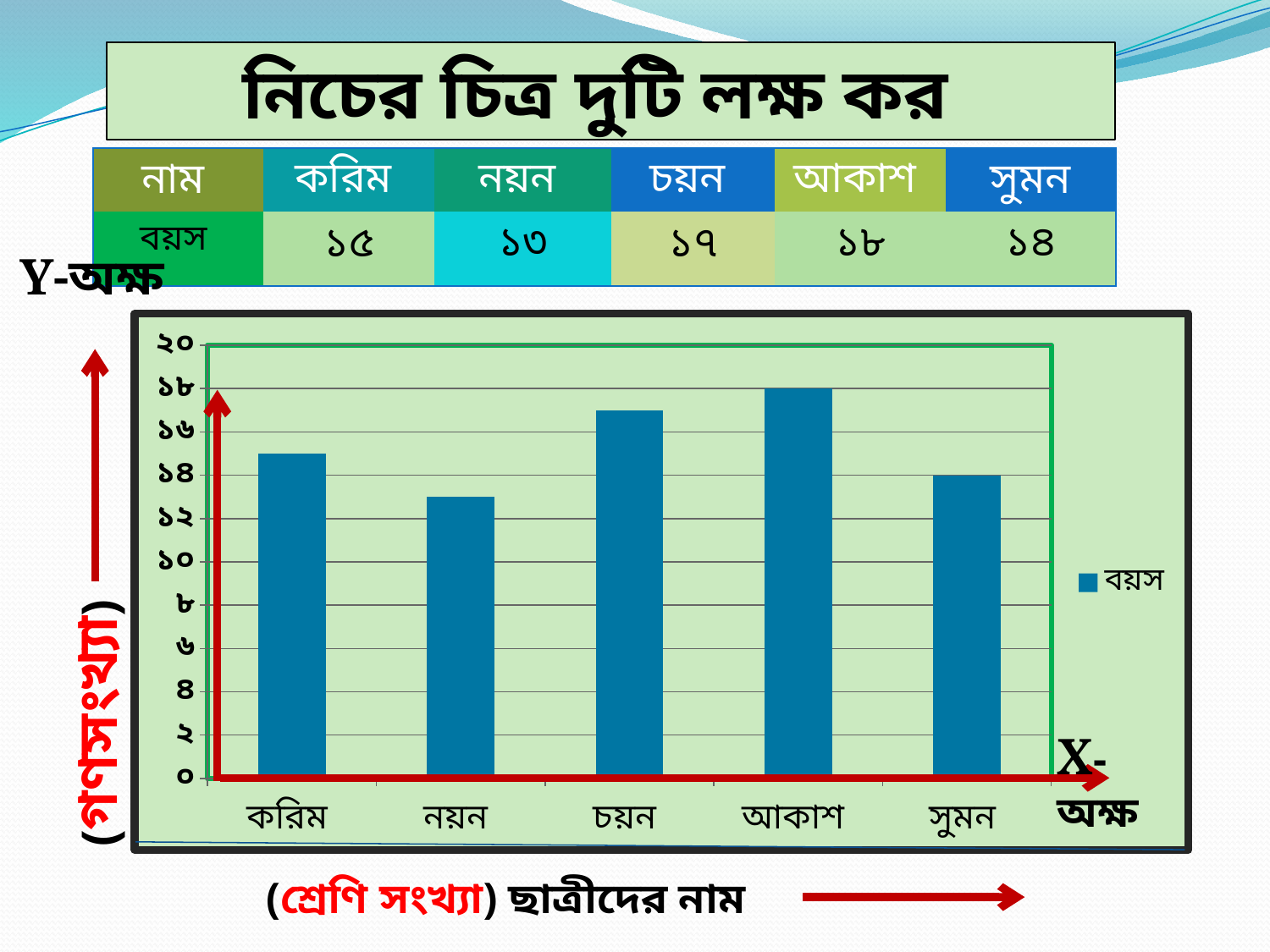
What kind of chart is shown on the slide? bar chart What is the value of the bar for সুমন? ১৪ Which category has the shortest bar in the chart? নয়ন What is the single series name listed in the chart legend? বয়স Is the value for করিম greater or less than ১৬? less What is the difference between the bars for আকাশ and সুমন? ৪ Which bar is taller, চয়ন or করিম? চয়ন Which category has the tallest bar in the chart? আকাশ How many categories are shown on the x axis of the chart? 5 Is the value for নয়ন greater or less than ১২? greater Is the value for চয়ন greater or less than ১৬? greater What is the value of the bar for আকাশ? ১৮